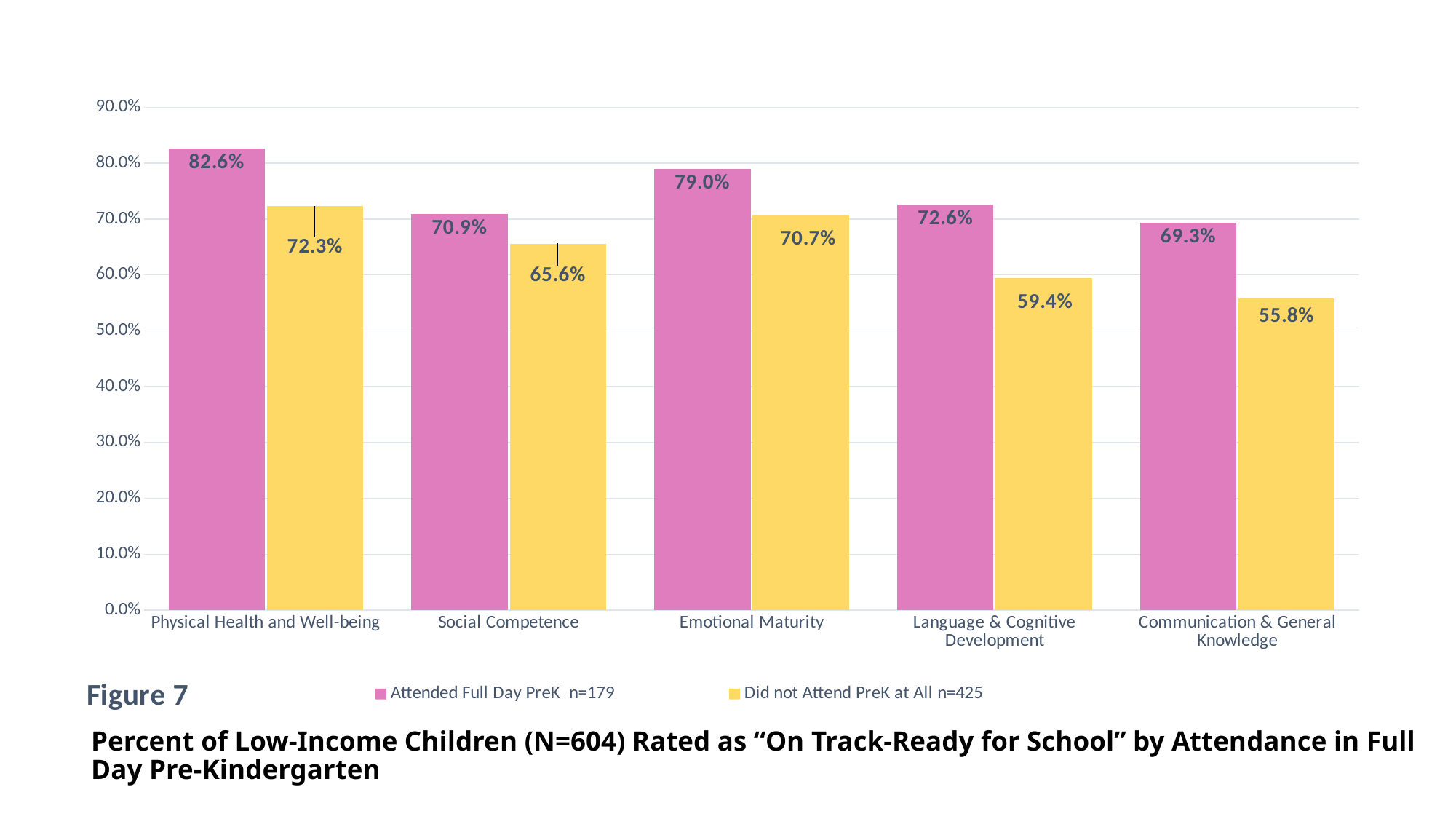
Which is larger: the Did not Attend PreK at All value for Social Competence or for Emotional Maturity? Emotional Maturity What percent of low-income children who attended full day PreK were rated on track for Physical Health and Well-being? 82.6% What colour are the bars for Attended Full Day PreK? Pink How many categories are shown on the x axis? 5 What is the value for Attended Full Day PreK in the Emotional Maturity category? 79.0% How many series does the legend list? 2 What is the value for Did not Attend PreK at All in the Language & Cognitive Development category? 59.4% Which category has the highest value for Attended Full Day PreK? Physical Health and Well-being What kind of chart is shown on the slide? Bar chart What is the difference between the Attended Full Day PreK and Did not Attend PreK at All values for Language & Cognitive Development? 13.2% Which category has the lowest value for Did not Attend PreK at All? Communication & General Knowledge Is the value for Did not Attend PreK at All in Communication & General Knowledge greater or less than 60.0%? less